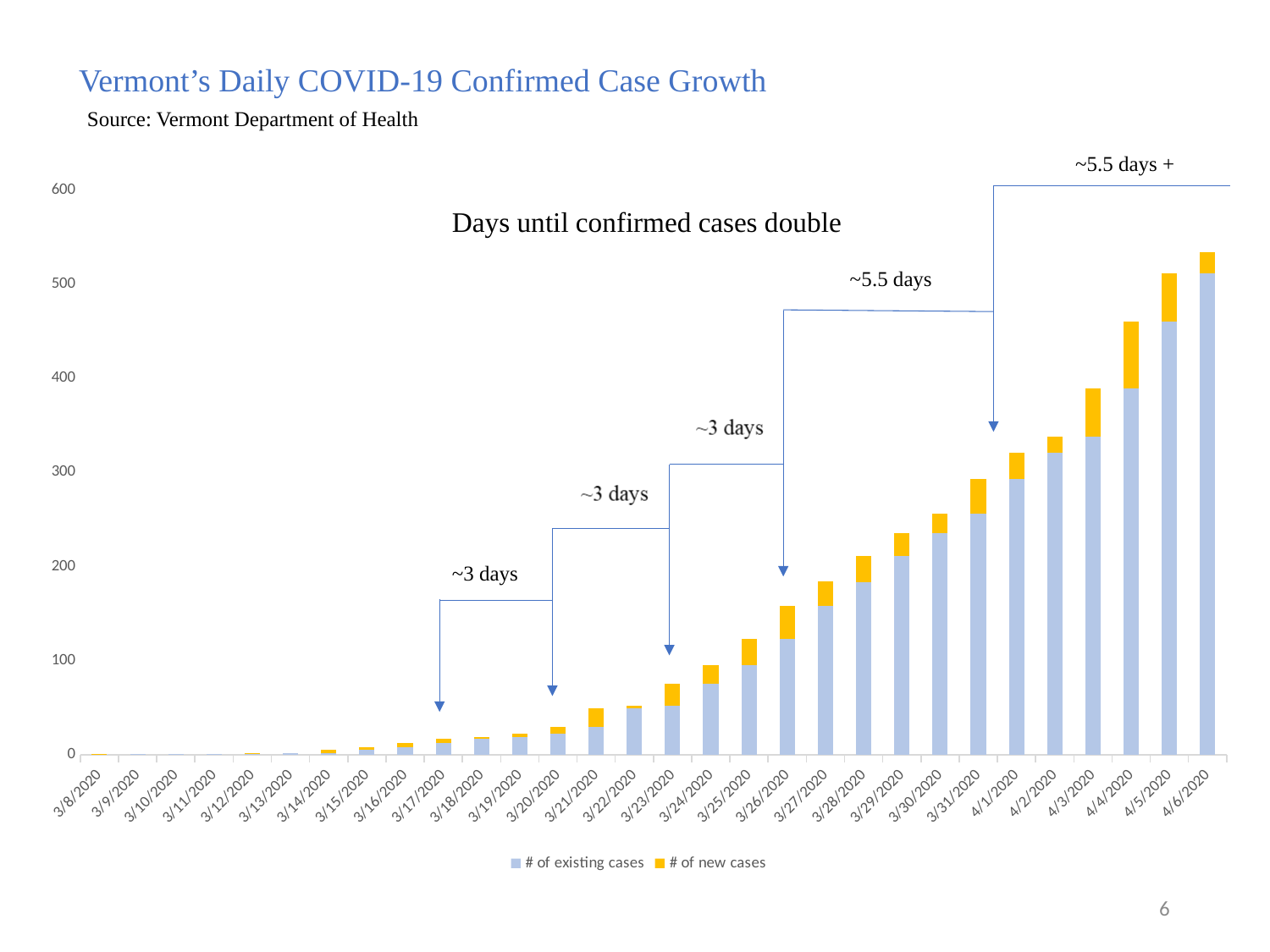
Do the bar totals rise or fall from 3/8/2020 to 4/6/2020? rise What is the title of the chart on the slide? Vermont's Daily COVID-19 Confirmed Case Growth How many series does the legend list? 2 What kind of chart is shown on the slide? stacked bar chart Is the total bar height for 4/6/2020 greater or less than 500? greater Is the total bar height for 3/26/2020 greater or less than 200? less Is the total bar height for 4/4/2020 greater or less than 400? greater Which date has the tallest bar? 4/6/2020 What are the two series named in the legend? # of existing cases and # of new cases How many dates are shown along the x axis? 30 Which date has the taller bar, 4/1/2020 or 3/25/2020? 4/1/2020